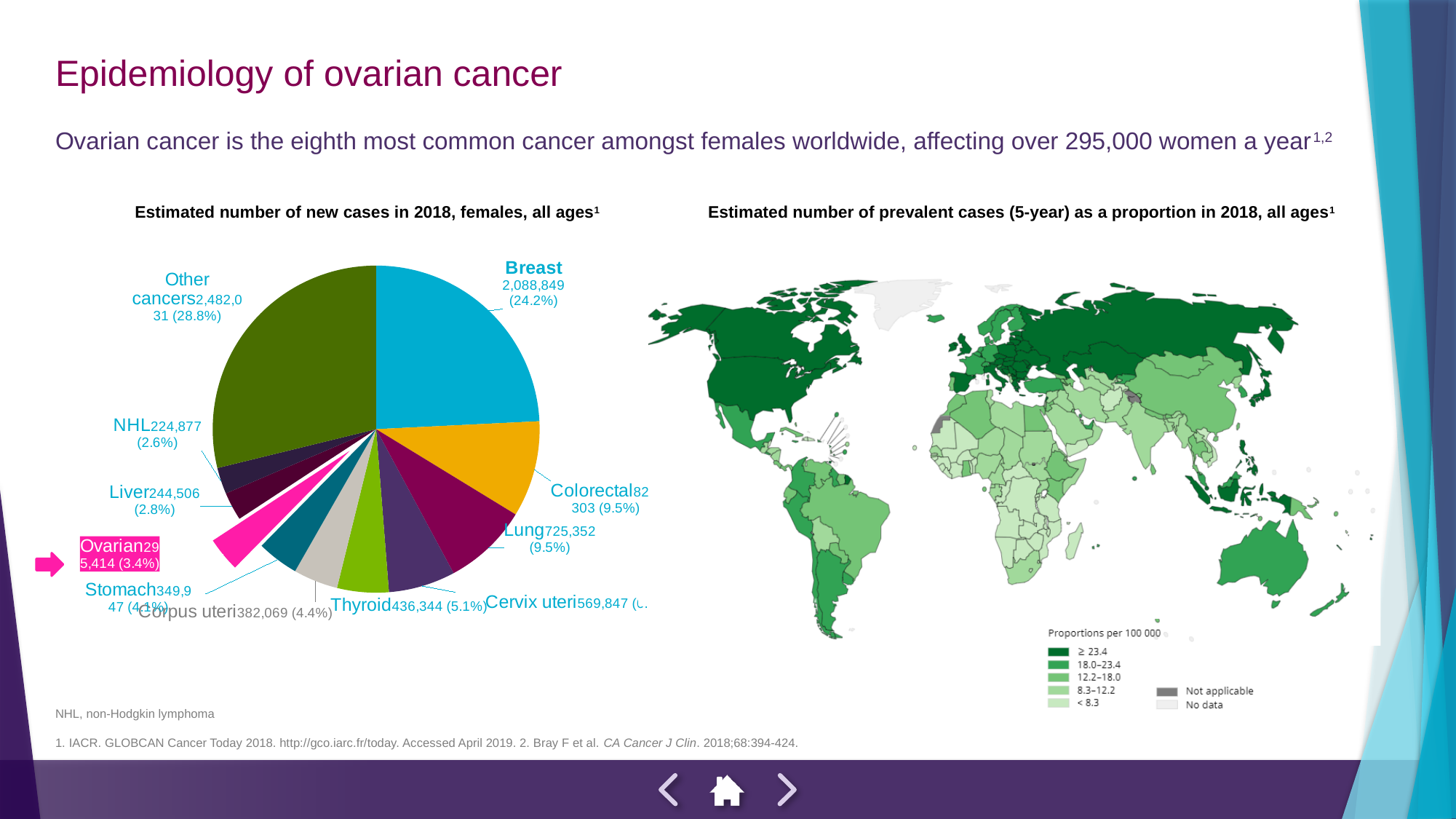
What type of chart is used on the left side of the slide to show new cases in 2018? Pie chart On the pie chart, what percentage of new cases is attributed to ovarian cancer? 3.4% On the pie chart, what percentage share does thyroid cancer have? 5.1% On the pie chart, what is the difference between the number of new breast cancer cases and new lung cancer cases? 1,363,497 On the pie chart, which slice is the largest? Other cancers On the pie chart, what is the estimated number of new lung cancer cases in females? 725,352 On the pie chart, how many more new stomach cancer cases are there than ovarian cancer cases? 54,533 On the pie chart, which named cancer type has the smallest number of new cases? NHL On the pie chart 'Estimated number of new cases in 2018, females, all ages', what is the estimated number of new breast cancer cases? 2,088,849 How many categories (slices) does the pie chart on the left contain? 11 On the pie chart, which has more new cases, colorectal cancer or lung cancer? Colorectal On the pie chart, what is the estimated number of new ovarian cancer cases? 295,414